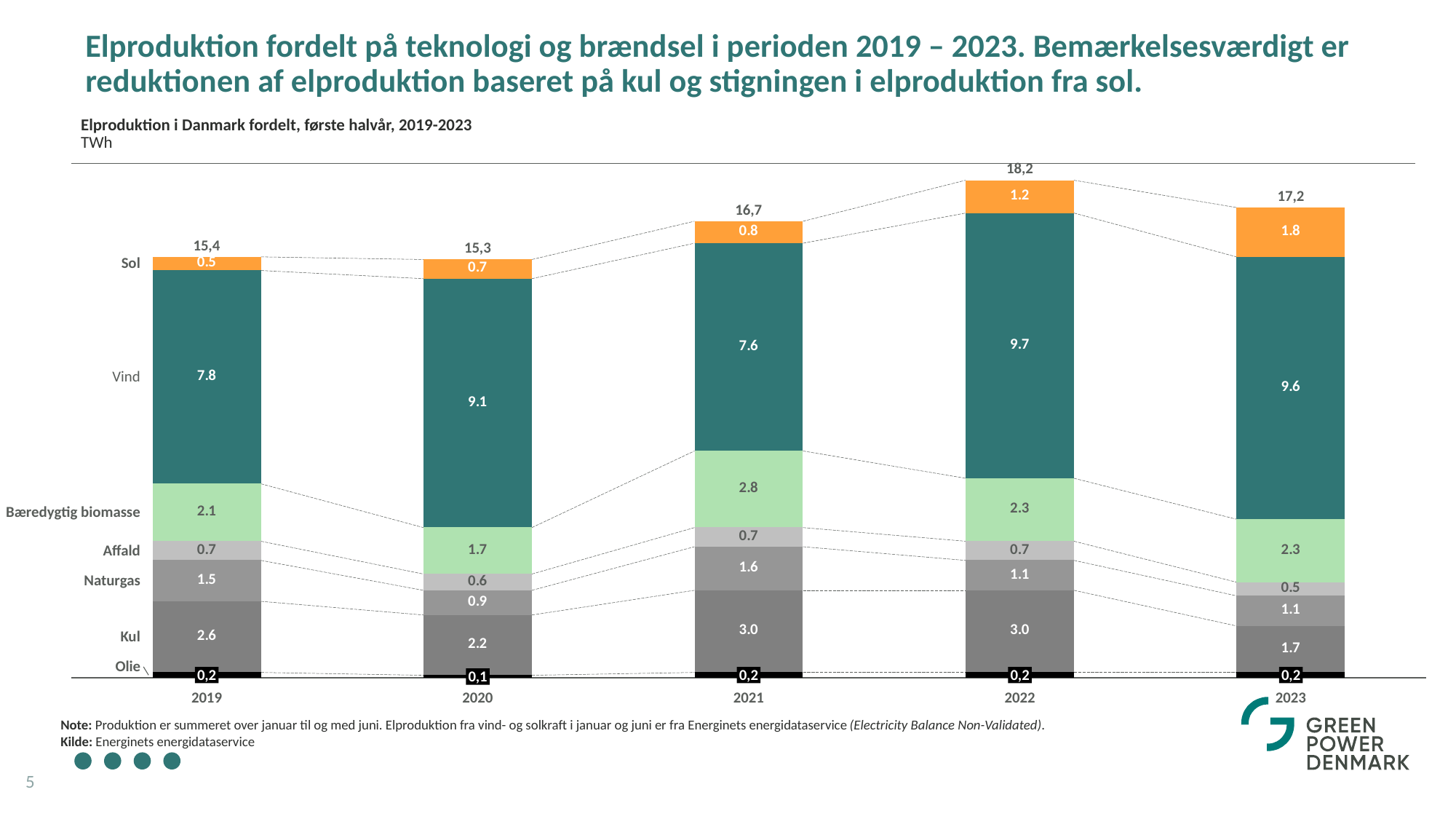
What is the total electricity production shown for 2022? 18,2 How many years (bars) are shown on the x axis? 5 What is the value for Vind (wind) in 2022? 9.7 Which year has the highest total electricity production? 2022 What is the value for Sol (solar) in 2023? 1.8 How many technology/fuel categories are stacked in each bar? 7 What is the difference in Kul (coal) production between 2022 and 2023? 1.3 What is the value for Kul (coal) in 2020? 2.2 What type of chart is shown on the slide? Stacked bar chart Which year has the lowest total electricity production? 2020 Which is larger, Bæredygtig biomasse in 2021 or in 2020? 2021 How much did Sol (solar) production increase from 2019 to 2023? 1.3